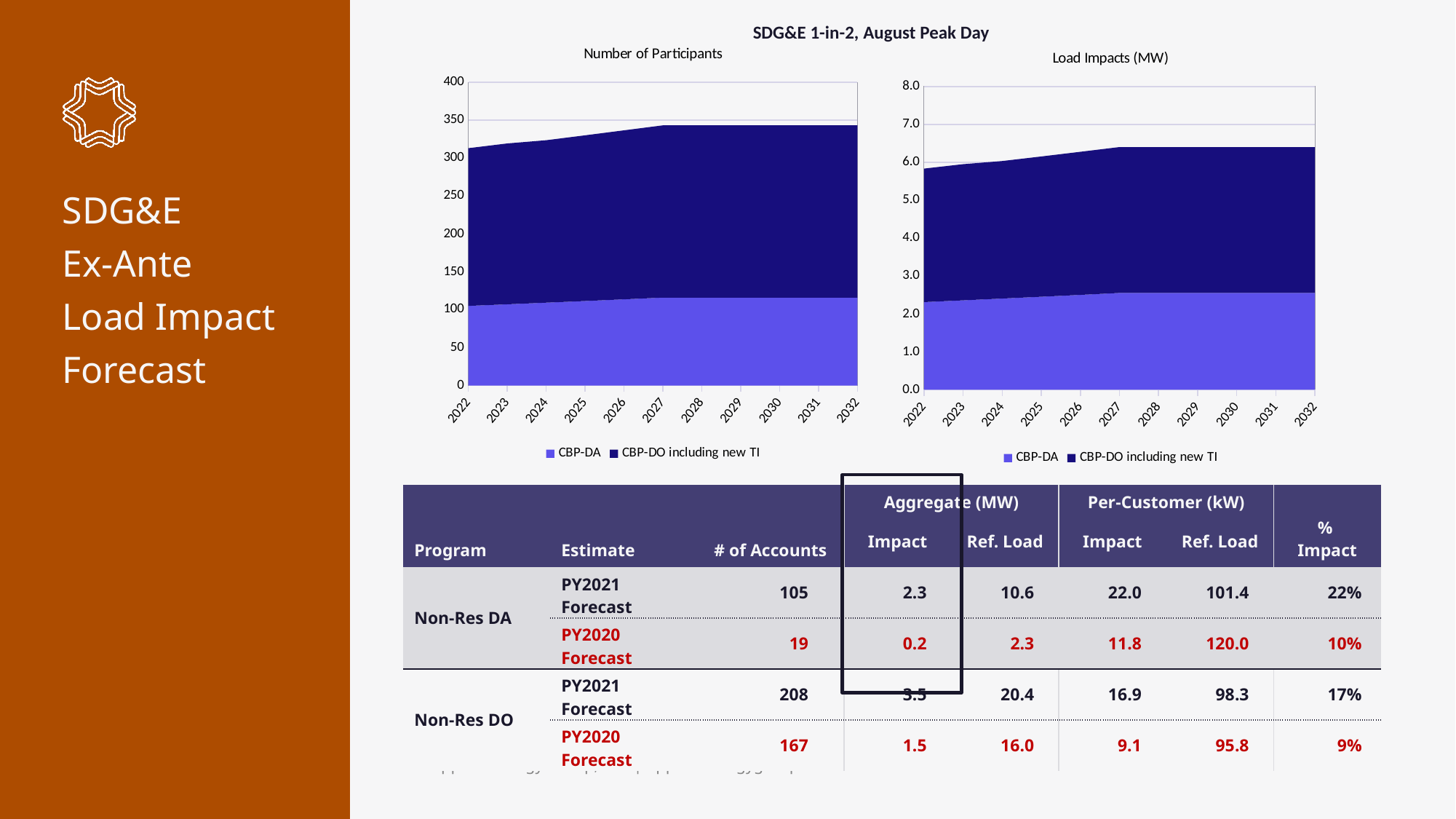
In the "Load Impacts (MW)" chart, is the total load impact in 2032 greater or less than 6.0? greater What kind of chart is the "Number of Participants" chart? stacked area chart In the "Number of Participants" chart, is the CBP-DA value in 2022 greater or less than 150? less What is the overall title above the two charts? SDG&E 1-in-2, August Peak Day How many series does the legend of the "Load Impacts (MW)" chart list? 2 In the "Load Impacts (MW)" chart, does the total load impact rise or fall from 2022 to 2032? rise How many years are shown on the x axis of the "Number of Participants" chart? 11 In the "Number of Participants" chart, is the total number of participants in 2022 greater or less than 350? less In the "Number of Participants" chart, which series has the larger value in 2032, CBP-DA or CBP-DO including new TI? CBP-DO including new TI In the "Number of Participants" chart, which series is shown in the darker blue? CBP-DO including new TI